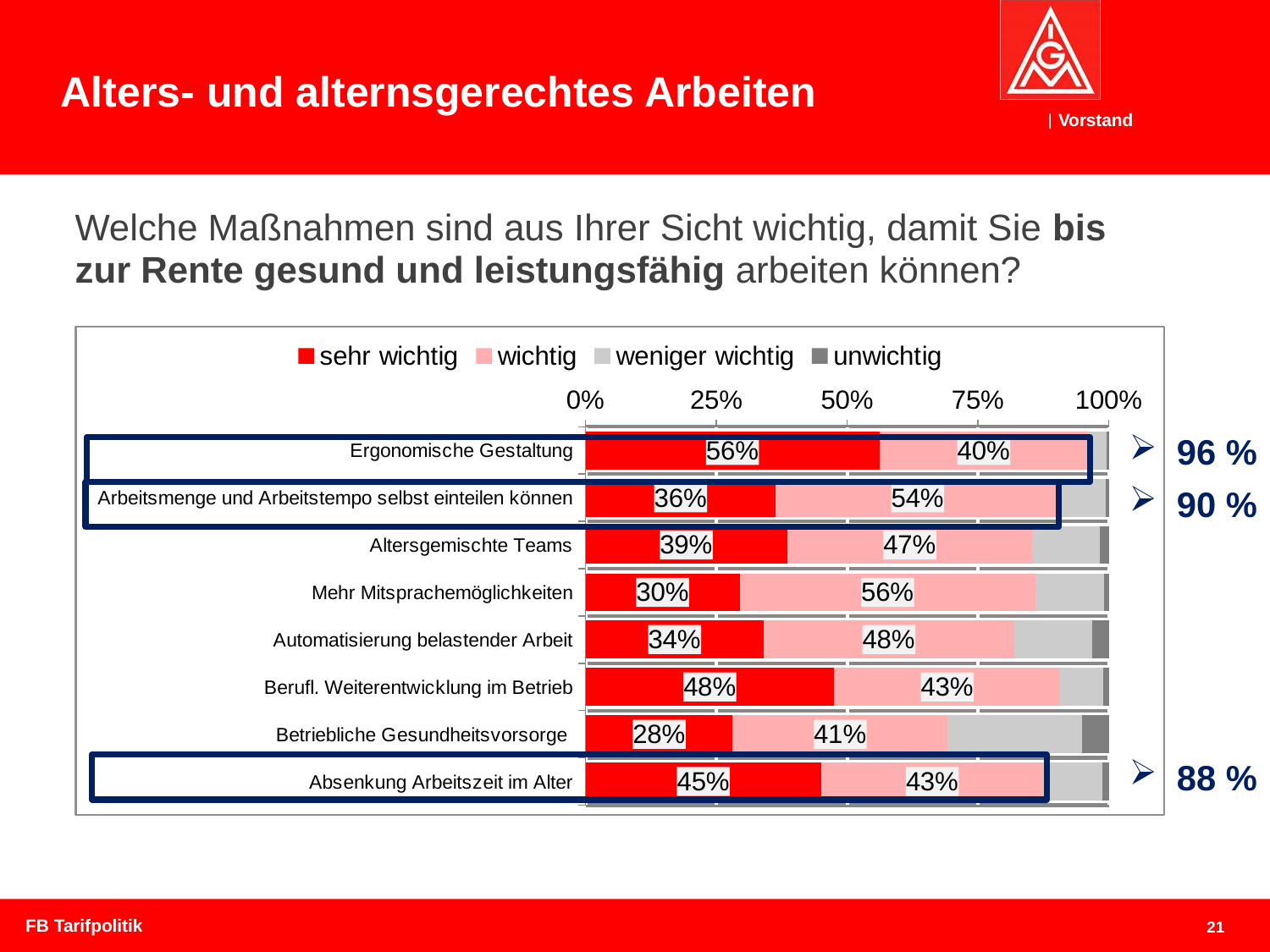
What percentage of respondents rated 'Ergonomische Gestaltung' as 'sehr wichtig'? 56% How many measures (categories) are shown in the chart? 8 How many series does the legend list? 4 What is the 'sehr wichtig' value for 'Absenkung Arbeitszeit im Alter'? 45% Which measure has the lowest 'sehr wichtig' share? Betriebliche Gesundheitsvorsorge What is the 'wichtig' value for 'Arbeitsmenge und Arbeitstempo selbst einteilen können'? 54% What type of chart is shown on the slide? Stacked bar chart Which measure has the highest 'sehr wichtig' share? Ergonomische Gestaltung What is the difference between the 'sehr wichtig' values for 'Berufl. Weiterentwicklung im Betrieb' and 'Mehr Mitsprachemöglichkeiten'? 18% Which has a larger 'wichtig' share: 'Mehr Mitsprachemöglichkeiten' or 'Altersgemischte Teams'? Mehr Mitsprachemöglichkeiten What is the combined share of 'sehr wichtig' and 'wichtig' for 'Ergonomische Gestaltung'? 96% Is the combined 'sehr wichtig' and 'wichtig' share for 'Betriebliche Gesundheitsvorsorge' greater or less than 75%? less